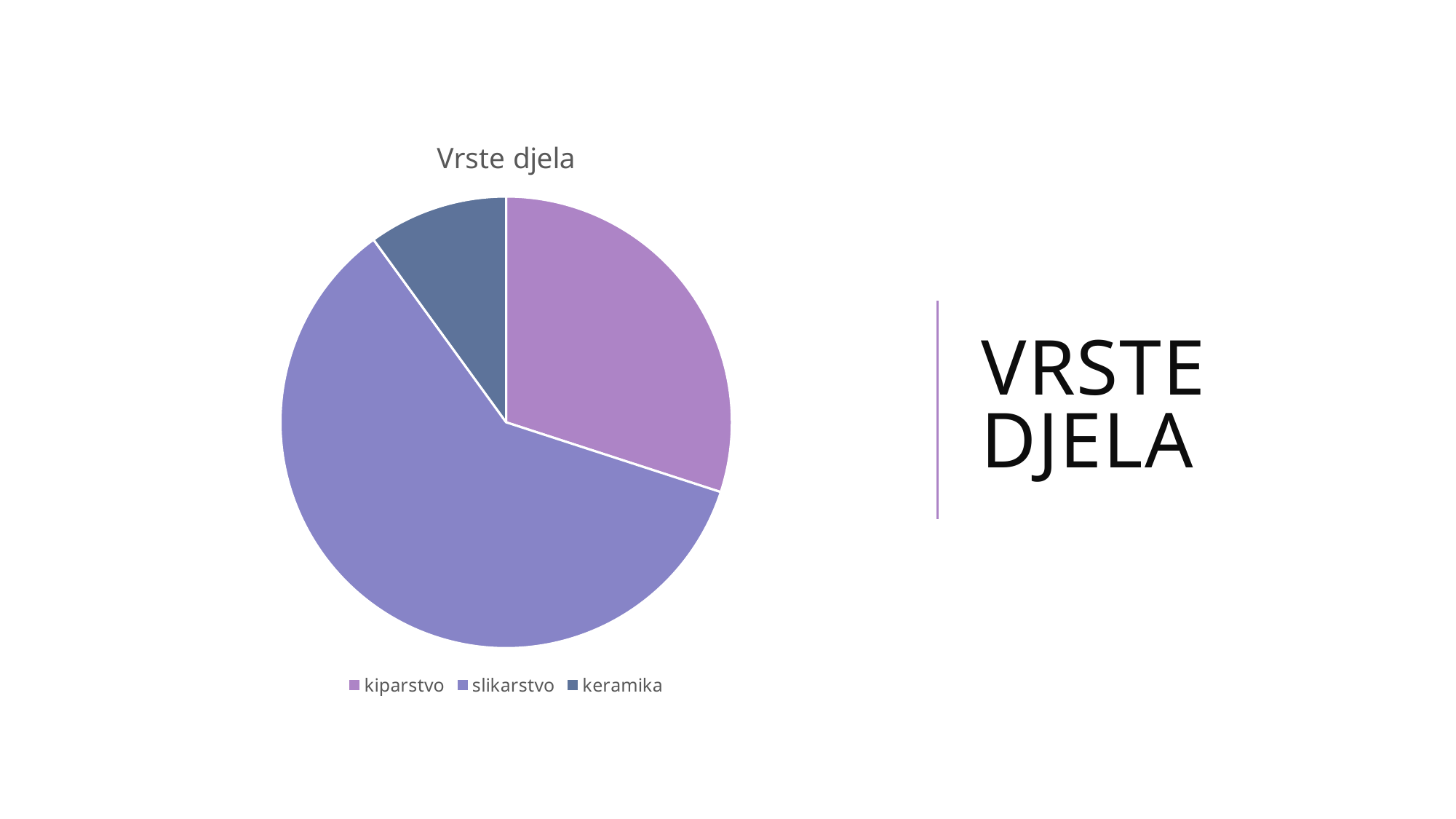
Which category is shown in the dark blue-grey colour? keramika How many slices does the pie chart have? 3 Which category has the largest slice of the pie? slikarstvo What kind of chart is shown on the slide? pie chart Which category has the smallest slice of the pie? keramika Which slice is larger, kiparstvo or keramika? kiparstvo How many entries does the legend list? 3 What is the title of the chart? Vrste djela Which slice is larger, slikarstvo or kiparstvo? slikarstvo